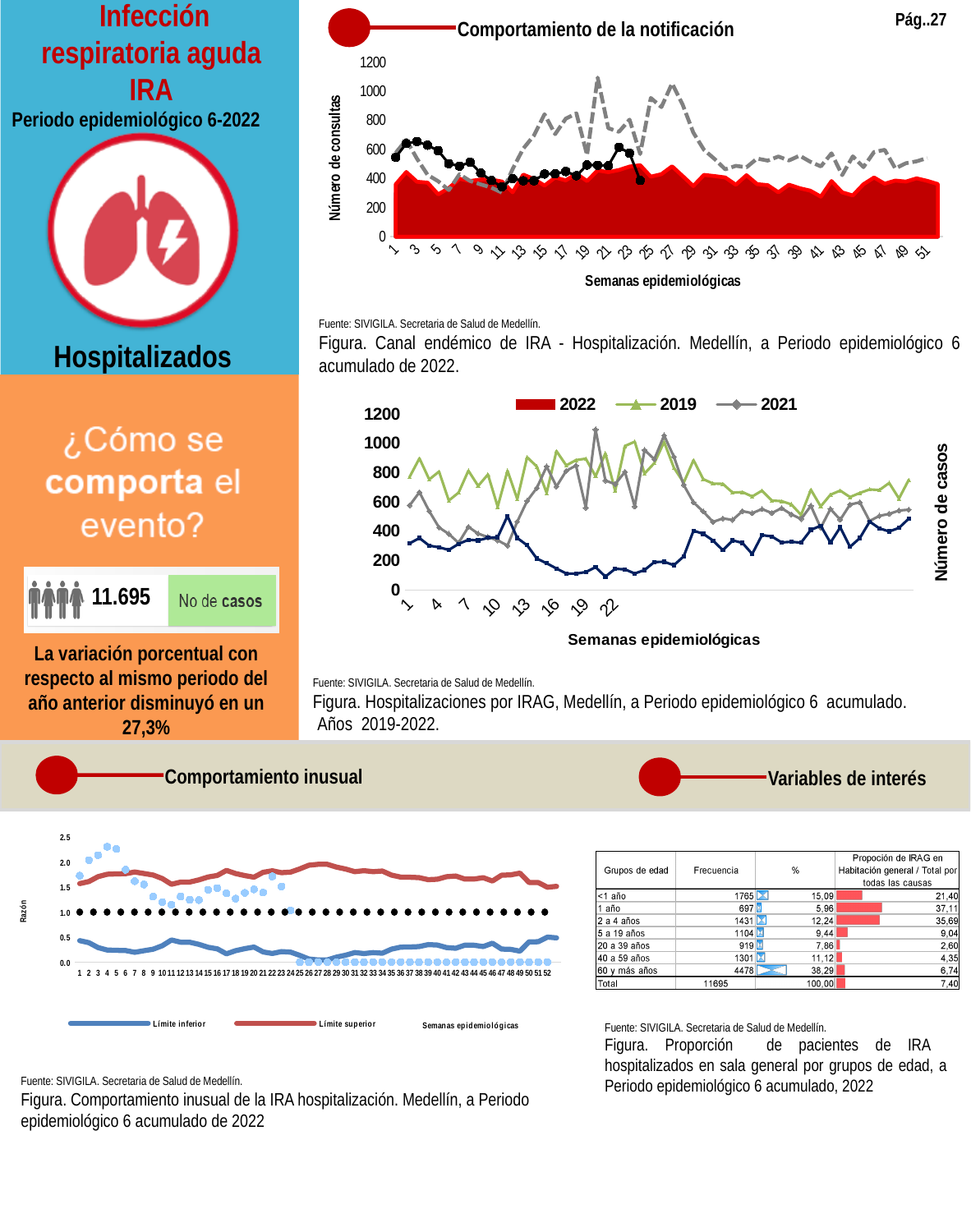
What kind of chart is the figure titled 'Hospitalizaciones por IRAG, Medellín, a Periodo epidemiológico 6 acumulado. Años 2019-2022'? Line chart How many series does the legend list in the chart 'Hospitalizaciones por IRAG' (middle right)? 3 In the chart 'Comportamiento inusual de la IRA hospitalización' (bottom left), which series has the larger value at week 30: 'Límite superior' or 'Límite inferior'? Límite superior In the chart 'Comportamiento de la notificación' (top right), is the value of the black dotted line at week 1 greater or less than 400? greater In the chart 'Comportamiento inusual de la IRA hospitalización' (bottom left), is the value of 'Límite superior' at week 1 greater or less than 1.0? greater In the chart 'Comportamiento inusual de la IRA hospitalización' (bottom left), is the value of 'Límite inferior' at week 1 greater or less than 1.0? less How many series does the legend list in the chart 'Comportamiento inusual de la IRA hospitalización' (bottom left)? 2 What is the title of the vertical axis in the chart 'Comportamiento de la notificación' (top right)? Número de consultas Which series are listed in the legend of the chart 'Hospitalizaciones por IRAG' (middle right)? 2022, 2019, 2021